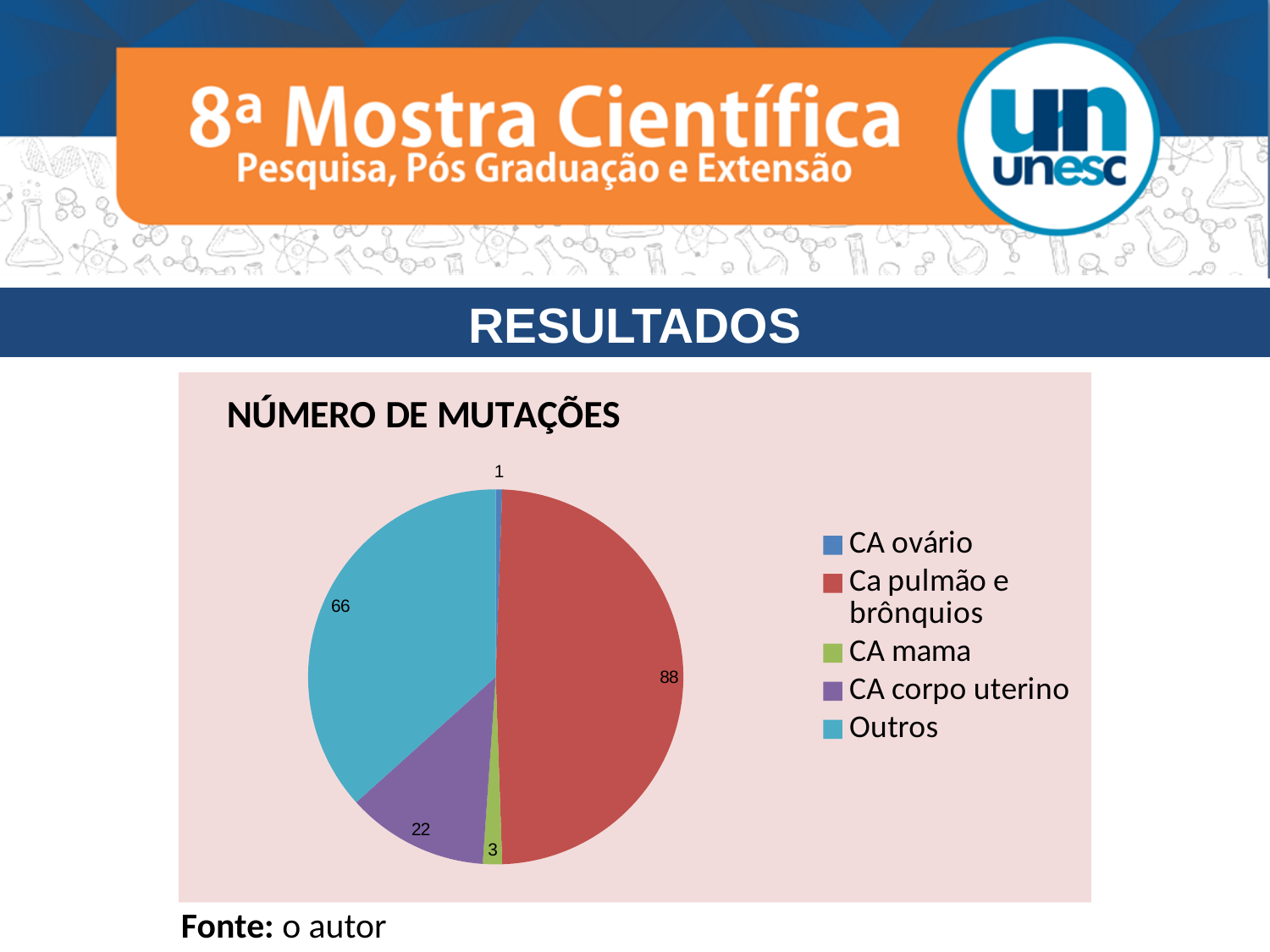
What is the value for Outros? 66 How many categories does the legend list? 5 What type of chart is shown on the slide? pie chart Which is larger, the value for CA corpo uterino or the value for CA mama? CA corpo uterino What is the value for CA mama? 3 What is the difference between the values for Ca pulmão e brônquios and Outros? 22 What is the value for Ca pulmão e brônquios? 88 What is the title of the chart? NÚMERO DE MUTAÇÕES Which category has the highest value? Ca pulmão e brônquios Which category has the lowest value? CA ovário What is the value for CA corpo uterino? 22 What is the value for CA ovário? 1